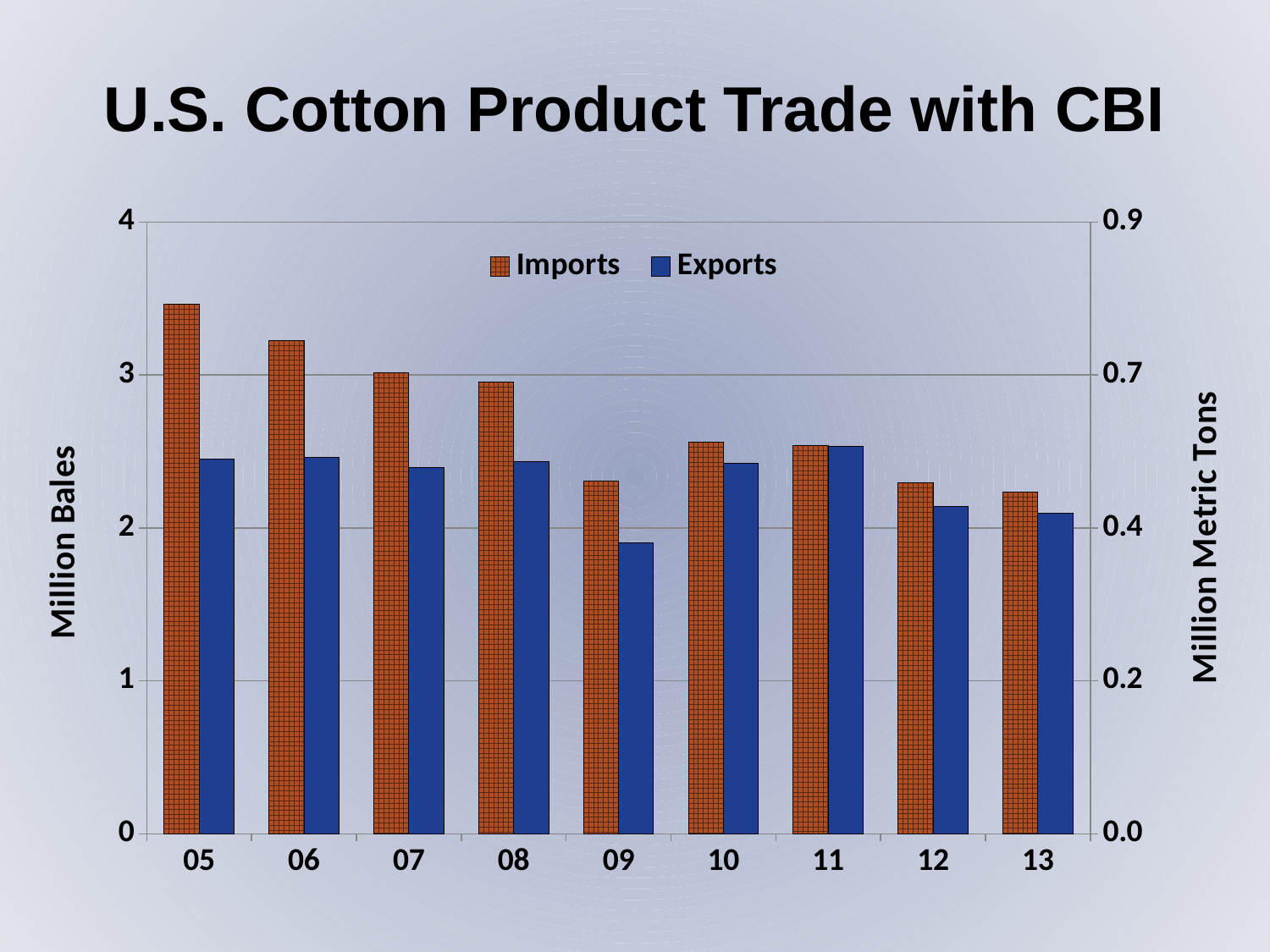
How many series does the legend list? 2 What is the label on the right-hand vertical axis? Million Metric Tons What kind of chart is shown on the slide? bar chart Which year has the highest Imports value? 05 Is the Imports value for 05 greater or less than 3 million bales? greater Is the Imports value for 06 greater or less than 3 on the left axis? greater Which year has the lowest Exports value? 09 How many years are shown on the x axis? 9 Do the Imports values generally rise or fall from 05 to 13? fall Is the Exports value for 09 greater or less than 2 on the left axis? less In 05, which is larger, Imports or Exports? Imports In 09, which is larger, Imports or Exports? Imports